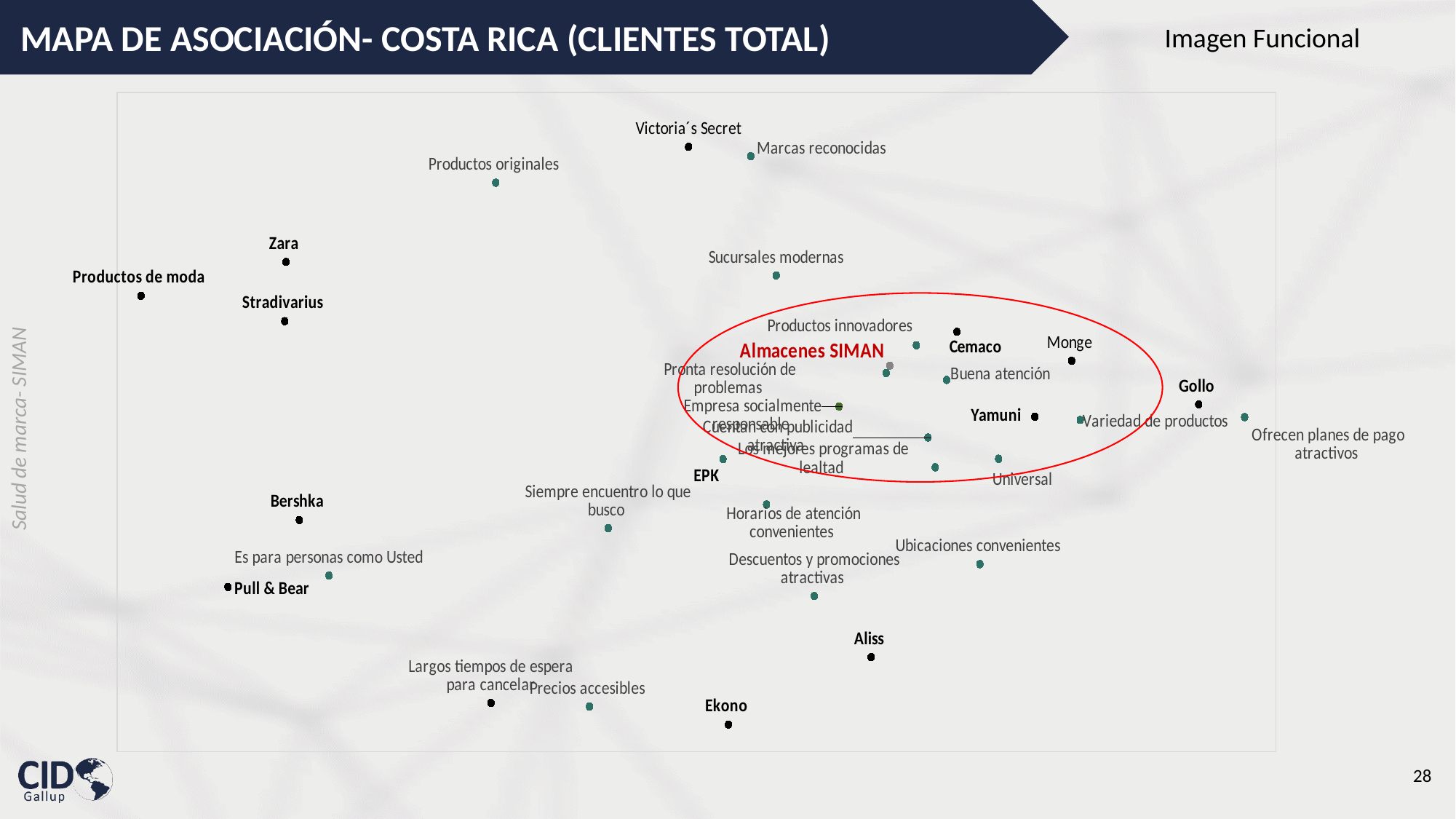
Is Gollo plotted to the left or to the right of Yamuni? Right Which brand is plotted closest to the attribute 'Variedad de productos'? Yamuni Which attribute is plotted closest to Pull & Bear? Es para personas como Usted Which brand is plotted highest (nearest the top) on the map? Victoria's Secret Which brand name is highlighted in red on the association map? Almacenes SIMAN Which attribute is plotted furthest to the right on the map? Ofrecen planes de pago atractivos What kind of chart is shown on the slide? Scatter chart (association map) Which labelled point is plotted furthest to the left on the map? Productos de moda Which attribute is plotted closest to Victoria's Secret? Marcas reconocidas Which brand is plotted lowest (nearest the bottom) on the map? Ekono What is the title of the chart on the slide? Mapa de asociación- Costa Rica (Clientes total) Is Zara plotted higher or lower on the map than Bershka? Higher